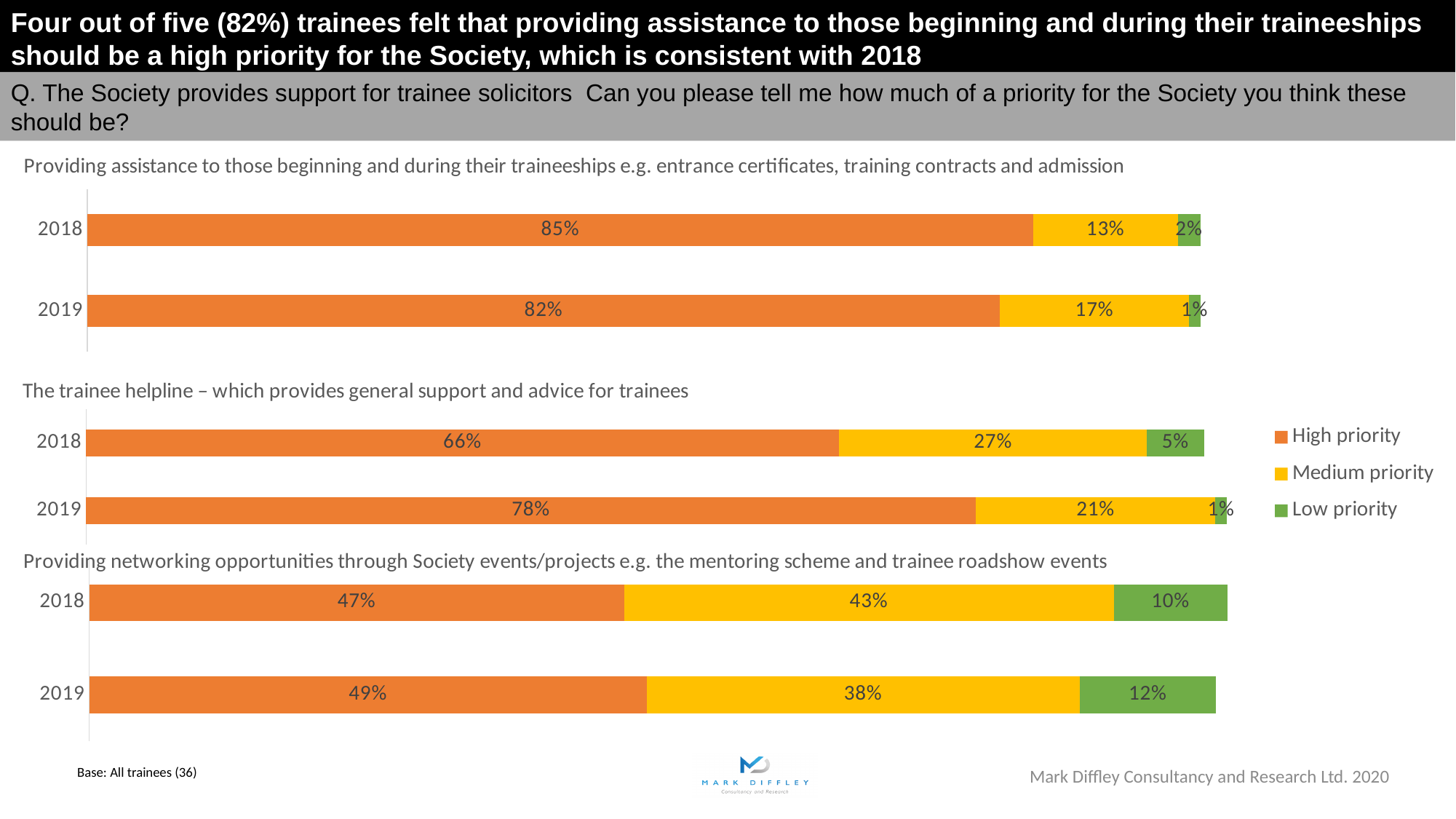
In the 'trainee helpline' chart, what is the low priority value for 2018? 5% In the 'Providing assistance to those beginning and during their traineeships' chart, which year has the higher medium priority value? 2019 In the 'trainee helpline' chart, by how many percentage points did the high priority value change from 2018 to 2019? 12 percentage points In the 'Providing assistance to those beginning and during their traineeships' chart, what is the medium priority value for 2018? 13% What type of chart is used on this slide? Stacked bar chart In the 'trainee helpline' chart, what is the high priority value for 2019? 78% Which colour represents 'Low priority' in the legend? Green In the 'Providing networking opportunities' chart, what is the medium priority value for 2019? 38% In the 'Providing assistance to those beginning and during their traineeships' chart, what percentage of trainees rated it a high priority in 2019? 82% In the 'Providing networking opportunities' chart, which year has the higher high priority value, 2018 or 2019? 2019 How many series does the legend list? 3 In the 'Providing networking opportunities' chart, what is the low priority value for 2018? 10%